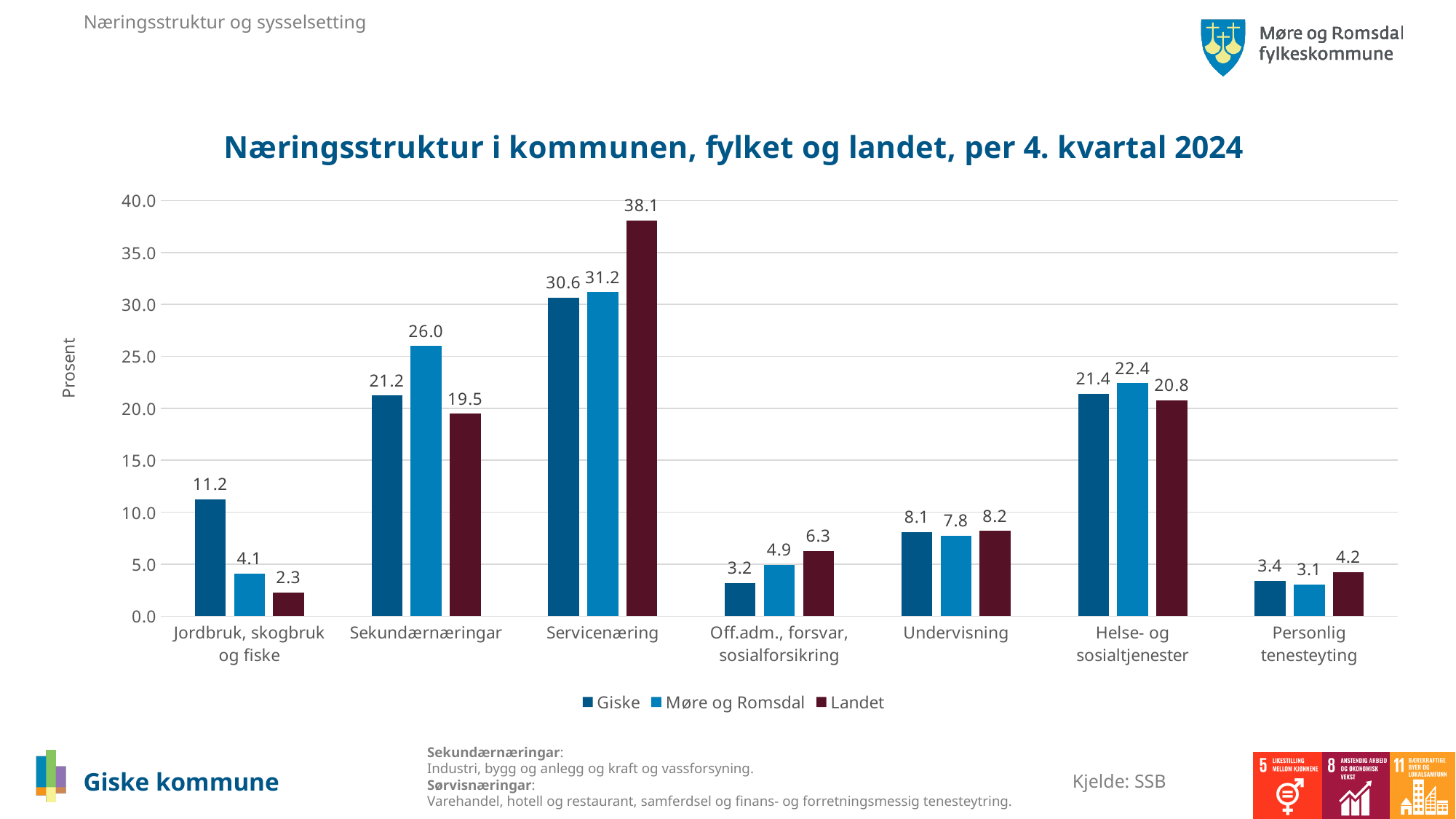
Which is larger in the Helse- og sosialtjenester category: Giske or Møre og Romsdal? Møre og Romsdal Which category has the highest value for Giske? Servicenæring What is the difference between the Landet and Giske values in the Servicenæring category? 7.5 What kind of chart is shown on the slide? Bar chart Is the value for Landet in the Sekundærnæringar category greater or less than 20.0? less How many categories are shown on the x axis? 7 What is the value for Giske in the Jordbruk, skogbruk og fiske category? 11.2 Which category has the lowest value for Landet? Jordbruk, skogbruk og fiske What is the value for Møre og Romsdal in the Sekundærnæringar category? 26.0 What is the label of the y axis? Prosent What is the value for Landet in the Servicenæring category? 38.1 How many series does the legend list? 3